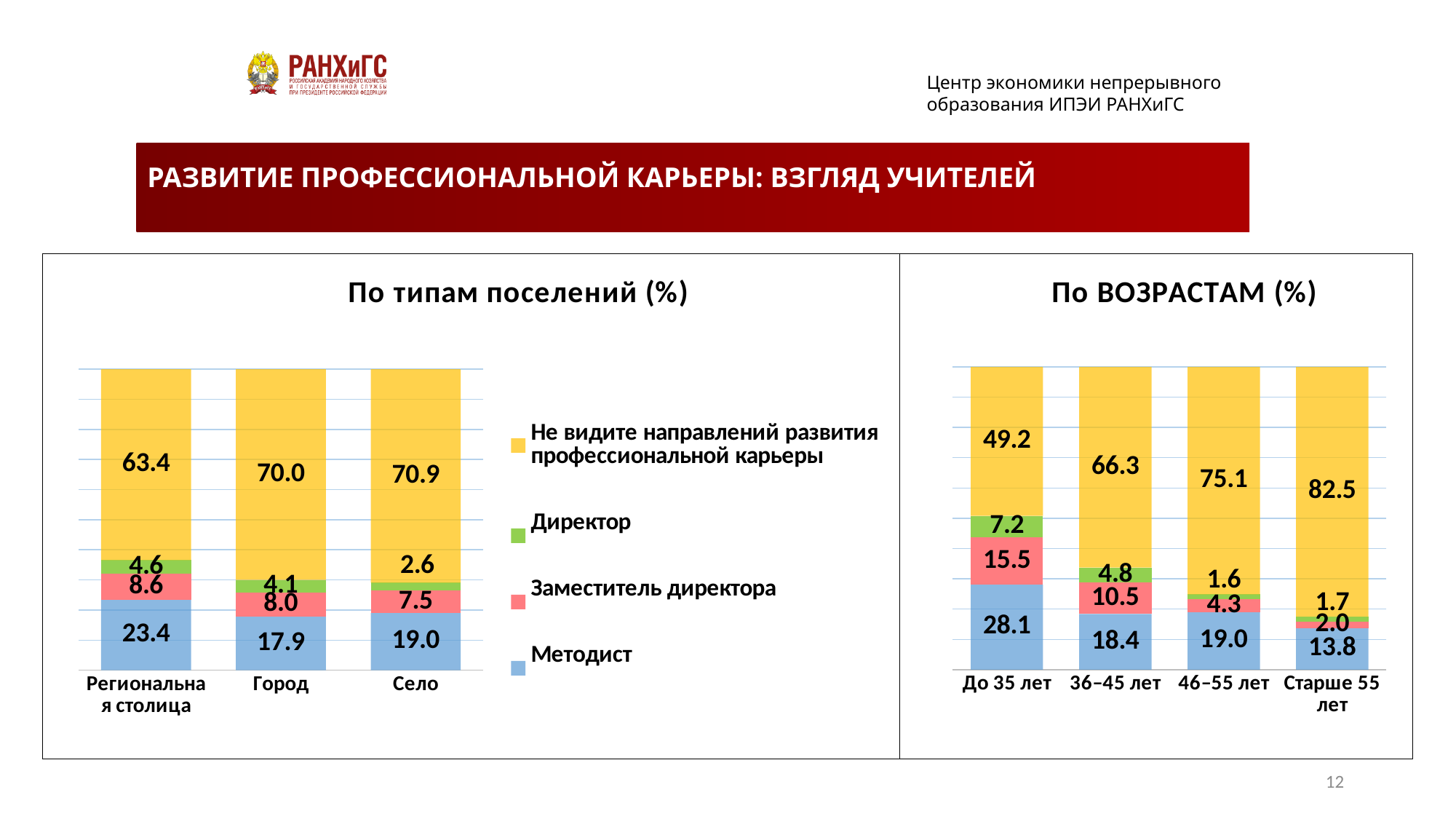
In the chart 'По ВОЗРАСТАМ (%)', what is the value for 'Заместитель директора' in 'До 35 лет'? 15.5 In the chart 'По ВОЗРАСТАМ (%)', which age group has the lowest value for 'Методист'? Старше 55 лет What type of chart is 'По ВОЗРАСТАМ (%)'? Stacked bar chart In the chart 'По ВОЗРАСТАМ (%)', does the value for 'Не видите направлений развития профессиональной карьеры' rise or fall from 'До 35 лет' to 'Старше 55 лет'? rise In the chart 'По типам поселений (%)', what is the value for 'Не видите направлений развития профессиональной карьеры' in 'Село'? 70.9 In the chart 'По типам поселений (%)', what is the difference between the 'Методист' values for 'Региональная столица' and 'Город'? 5.5 In the chart 'По типам поселений (%)', how many categories are shown on the x axis? 3 In the chart 'По типам поселений (%)', which category has the highest value for 'Директор'? Региональная столица In the chart 'По типам поселений (%)', how many series does the legend list? 4 In the chart 'По ВОЗРАСТАМ (%)', what is the total of the stacked bar for '46–55 лет'? 100.0 In the chart 'По типам поселений (%)', what is the value for 'Методист' in 'Региональная столица'? 23.4 In the chart 'По ВОЗРАСТАМ (%)', which is larger: 'Директор' for 'До 35 лет' or 'Директор' for '36–45 лет'? До 35 лет